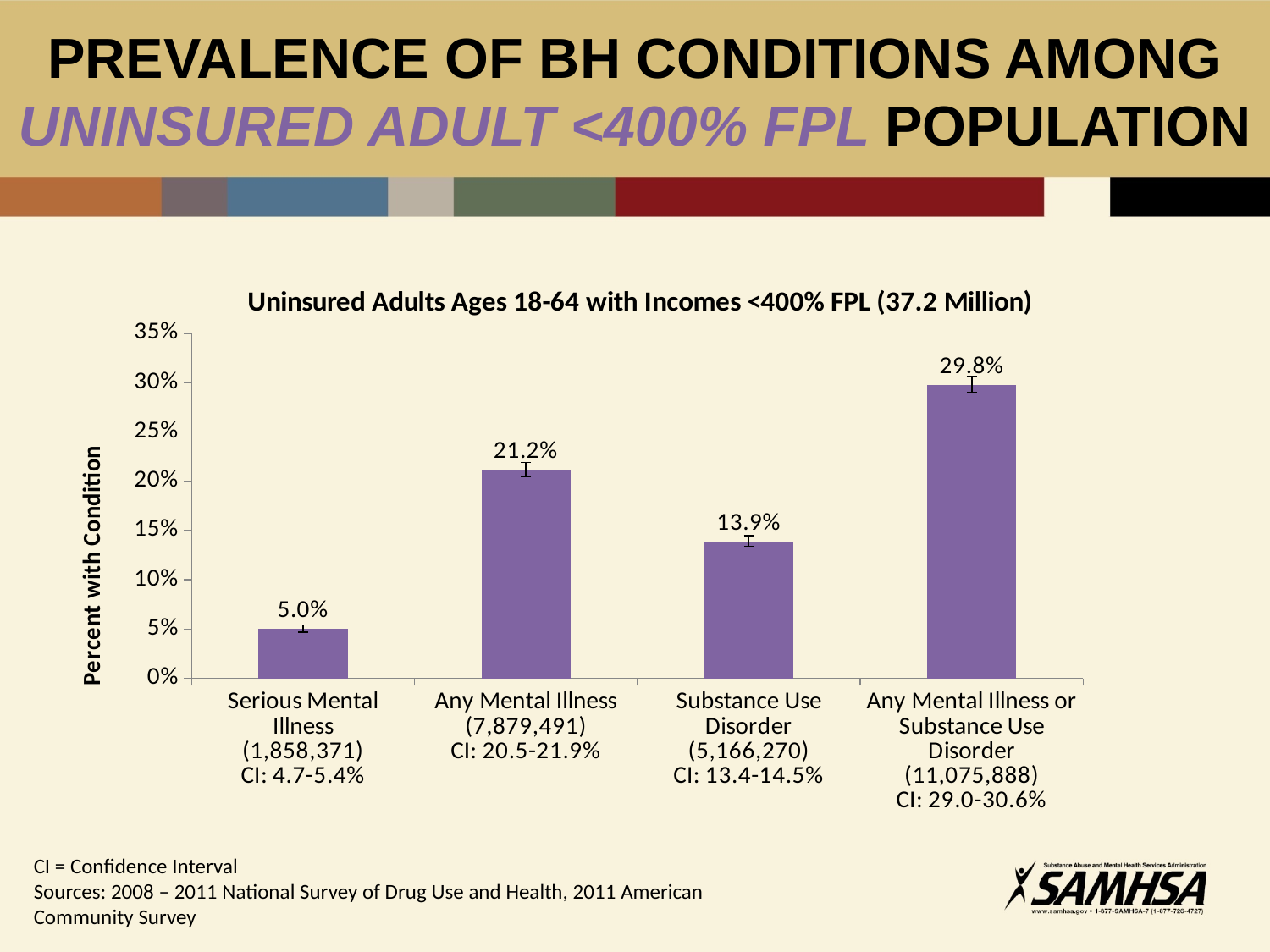
Which category has the highest value? Any Mental Illness or Substance Use Disorder What kind of chart is shown? bar chart What is the value for Serious Mental Illness? 5.0% Is the value for Any Mental Illness or Substance Use Disorder greater or less than 25%? greater What is the difference between the values for Any Mental Illness and Substance Use Disorder? 7.3% What is the value for Substance Use Disorder? 13.9% How many categories are shown on the x axis? 4 Which is larger, the value for Any Mental Illness or the value for Substance Use Disorder? Any Mental Illness What is the title of the chart? Uninsured Adults Ages 18-64 with Incomes <400% FPL (37.2 Million) What is the value for Any Mental Illness or Substance Use Disorder? 29.8% What is the value for Any Mental Illness? 21.2% Which category has the lowest value? Serious Mental Illness